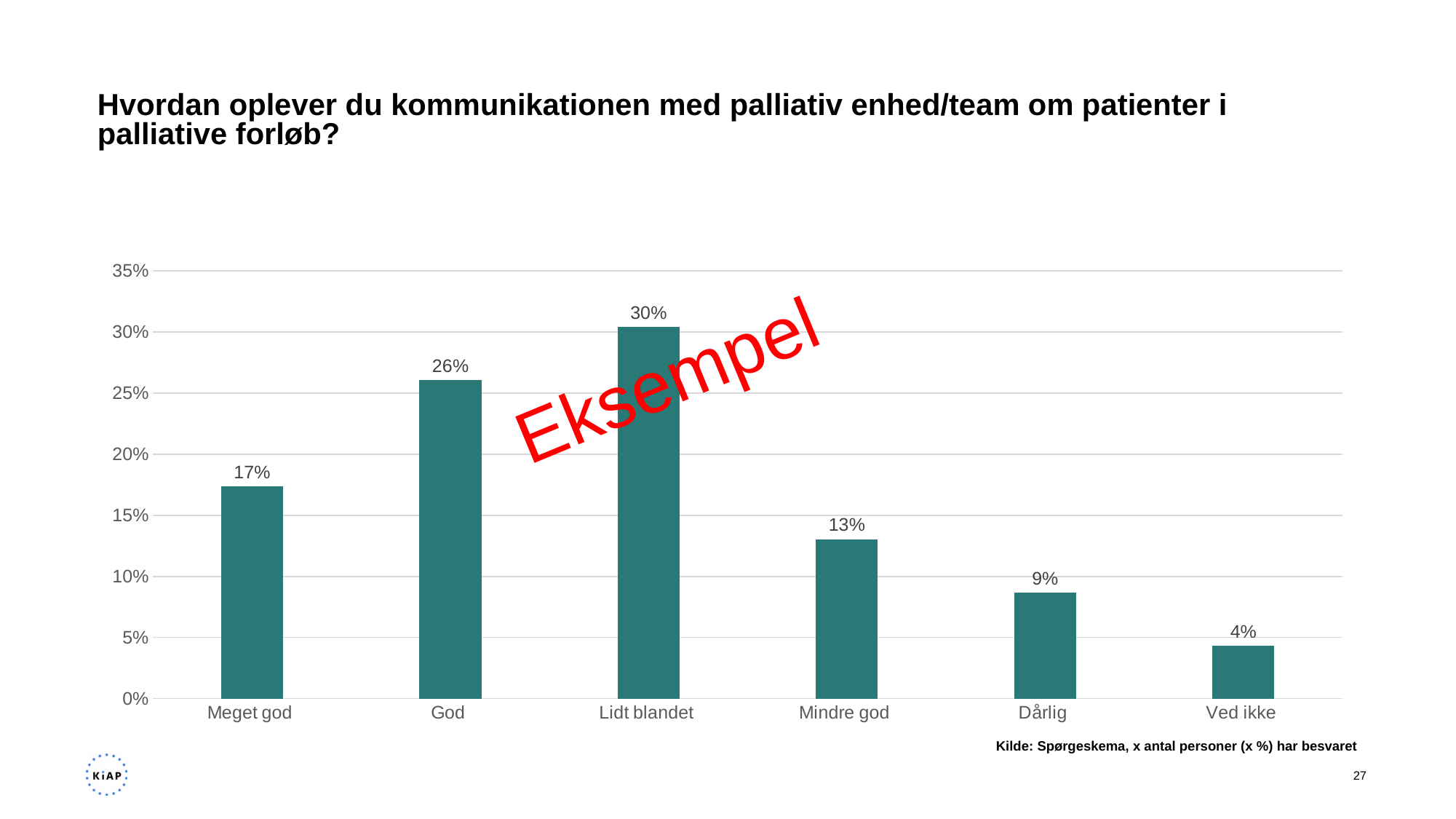
Do the values rise or fall from "Lidt blandet" to "Ved ikke" along the x axis? Fall Is the value for "God" greater or less than 25%? greater Which is larger, the value for "Meget god" or the value for "Dårlig"? Meget god What is the value for "Lidt blandet"? 30% What is the value for "Meget god"? 17% What is the difference between the values for "God" and "Mindre god"? 13% What is the value for "Ved ikke"? 4% What red word is overlaid diagonally across the chart? Eksempel Which category has the lowest value? Ved ikke What kind of chart is shown on the slide? Bar chart Which category has the highest value? Lidt blandet How many categories are shown on the x axis? 6